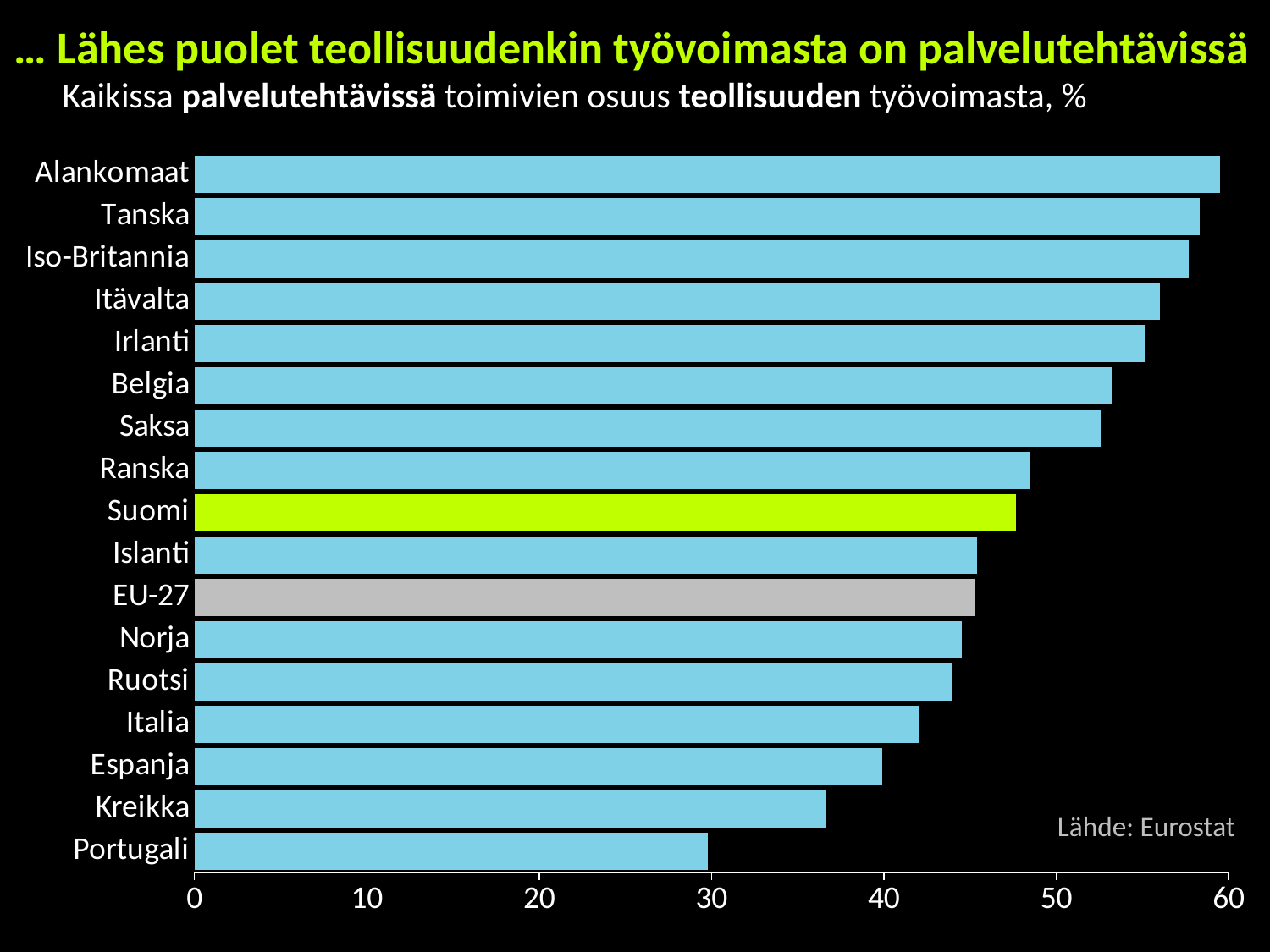
How many categories (bars) are shown in the chart? 17 Is the value for Italia greater or less than 40? greater Which has the larger value, Tanska or Saksa? Tanska What is the source of the data given on the slide? Eurostat Is the value for Suomi greater or less than 50? less Is the value for Kreikka greater or less than 40? less Which has the larger value, Suomi or Ruotsi? Suomi Which country has the highest share of industrial workforce in service tasks? Alankomaat Which bar is highlighted in a different colour (yellow-green) from the other countries? Suomi Which country has the lowest share of industrial workforce in service tasks? Portugali What kind of chart is shown on the slide? bar chart